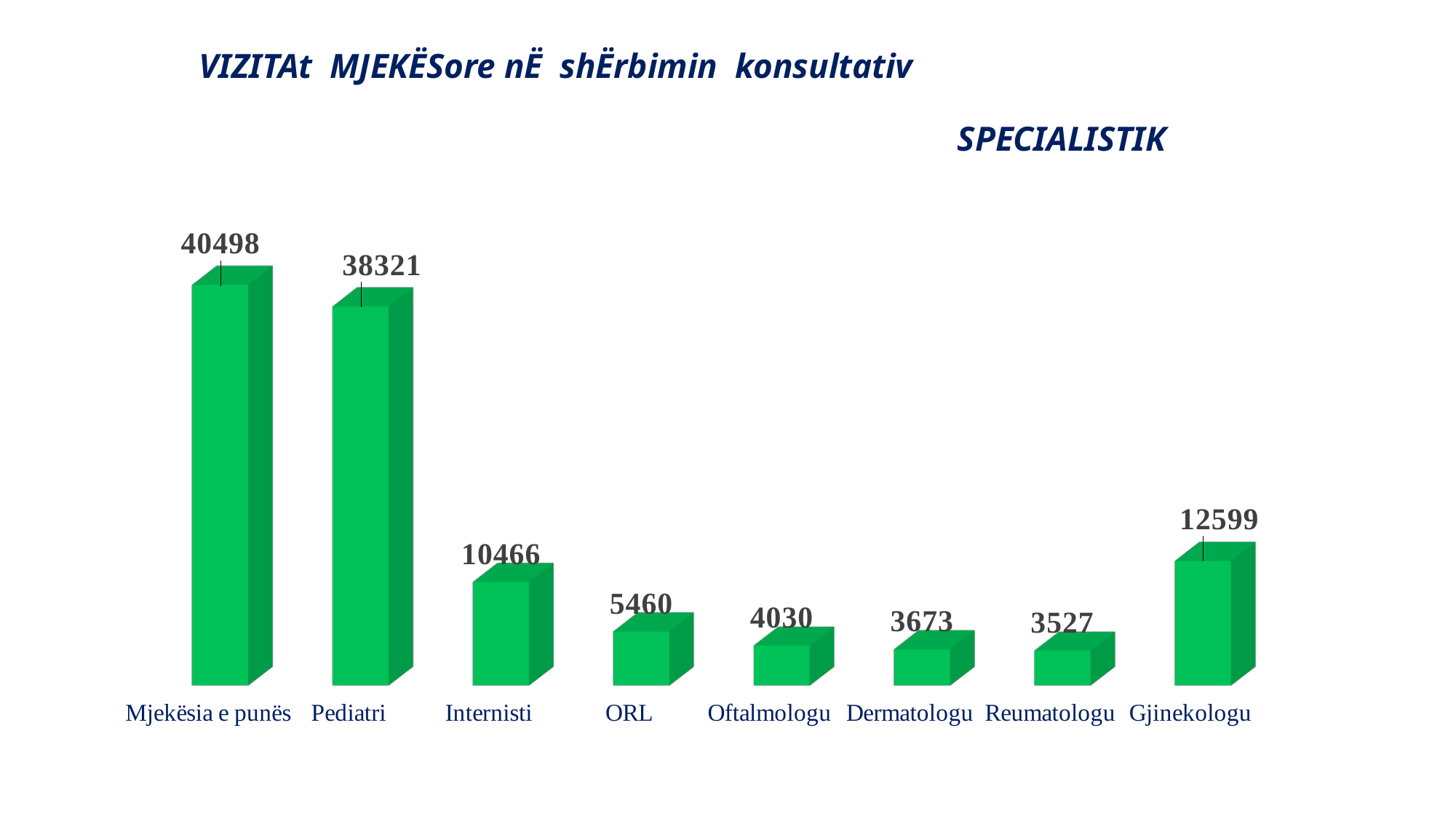
What is the value for Dermatologu? 3673 What colour are the bars in the chart? Green What is the value for Gjinekologu? 12599 What is the value for ORL? 5460 Which is larger, the value for Internisti or the value for Gjinekologu? Gjinekologu Which category has the highest value? Mjekësia e punës What is the difference between the values for Gjinekologu and Internisti? 2133 What is the value for Mjekësia e punës? 40498 What is the difference between the values for Mjekësia e punës and Pediatri? 2177 How many categories are shown in the chart? 8 Which category has the lowest value? Reumatologu What kind of chart is shown on the slide? Bar chart